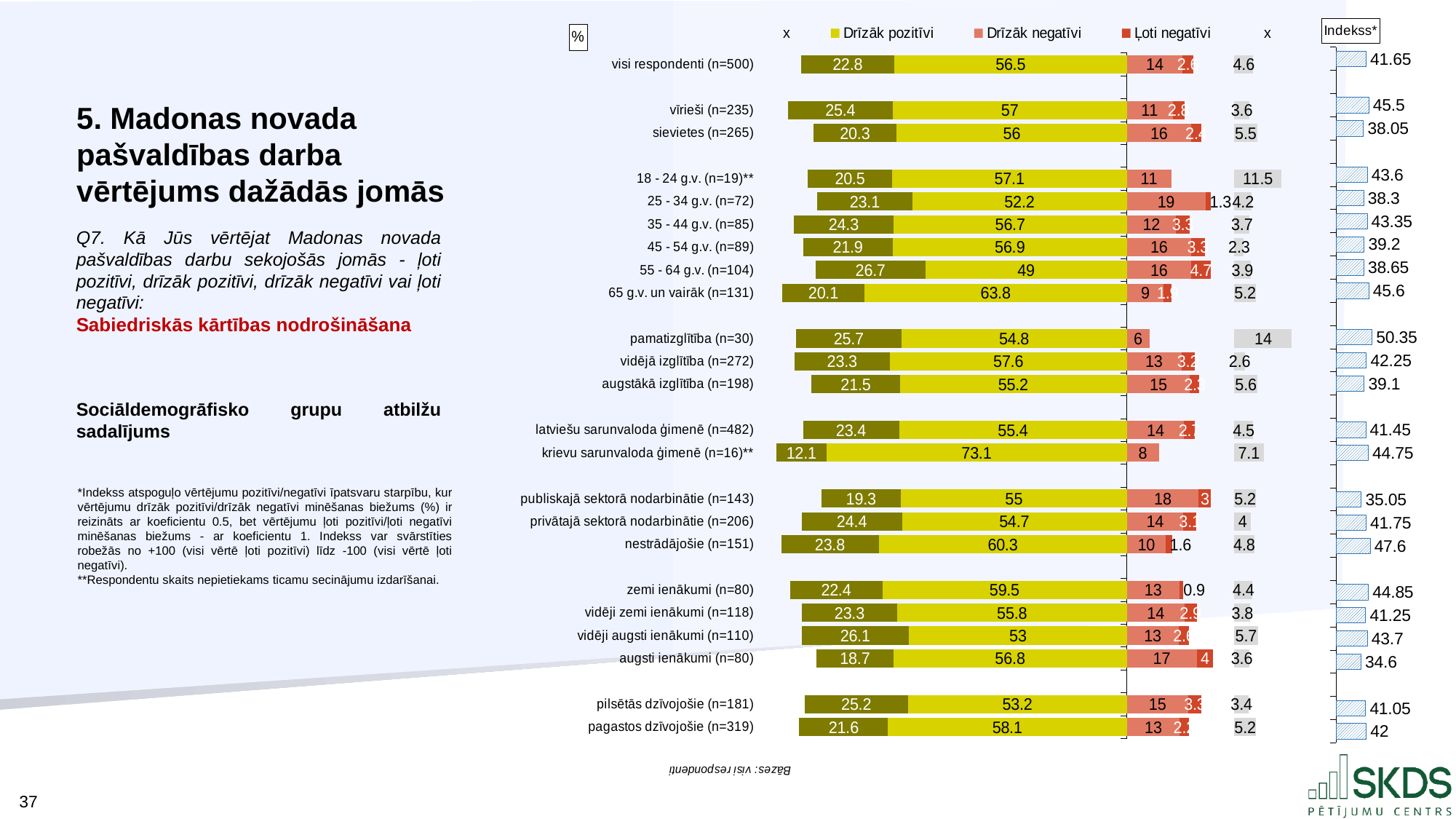
Which group has the highest Indekss* value? pamatizglītība (n=30) How many respondent groups are shown in the chart? 23 What is the 'Drīzāk negatīvi' value for 'publiskajā sektorā nodarbinātie (n=143)'? 18 Which colour represents 'Drīzāk pozitīvi' in the chart? Yellow What is the 'Drīzāk pozitīvi' value for 'visi respondenti (n=500)'? 56.5 Which group has the highest 'Drīzāk pozitīvi' value? krievu sarunvaloda ģimenē (n=16)** What is the 'Drīzāk pozitīvi' value for 'krievu sarunvaloda ģimenē (n=16)**'? 73.1 What is the difference between the Indekss* values for 'vīrieši (n=235)' and 'sievietes (n=265)'? 7.45 Which has a larger 'Drīzāk negatīvi' value: '25 - 34 g.v. (n=72)' or '65 g.v. un vairāk (n=131)'? 25 - 34 g.v. (n=72) What kind of chart is shown on the slide? Stacked bar chart Which group has the lowest Indekss* value? augsti ienākumi (n=80) What is the Indekss* value for 'pamatizglītība (n=30)'? 50.35